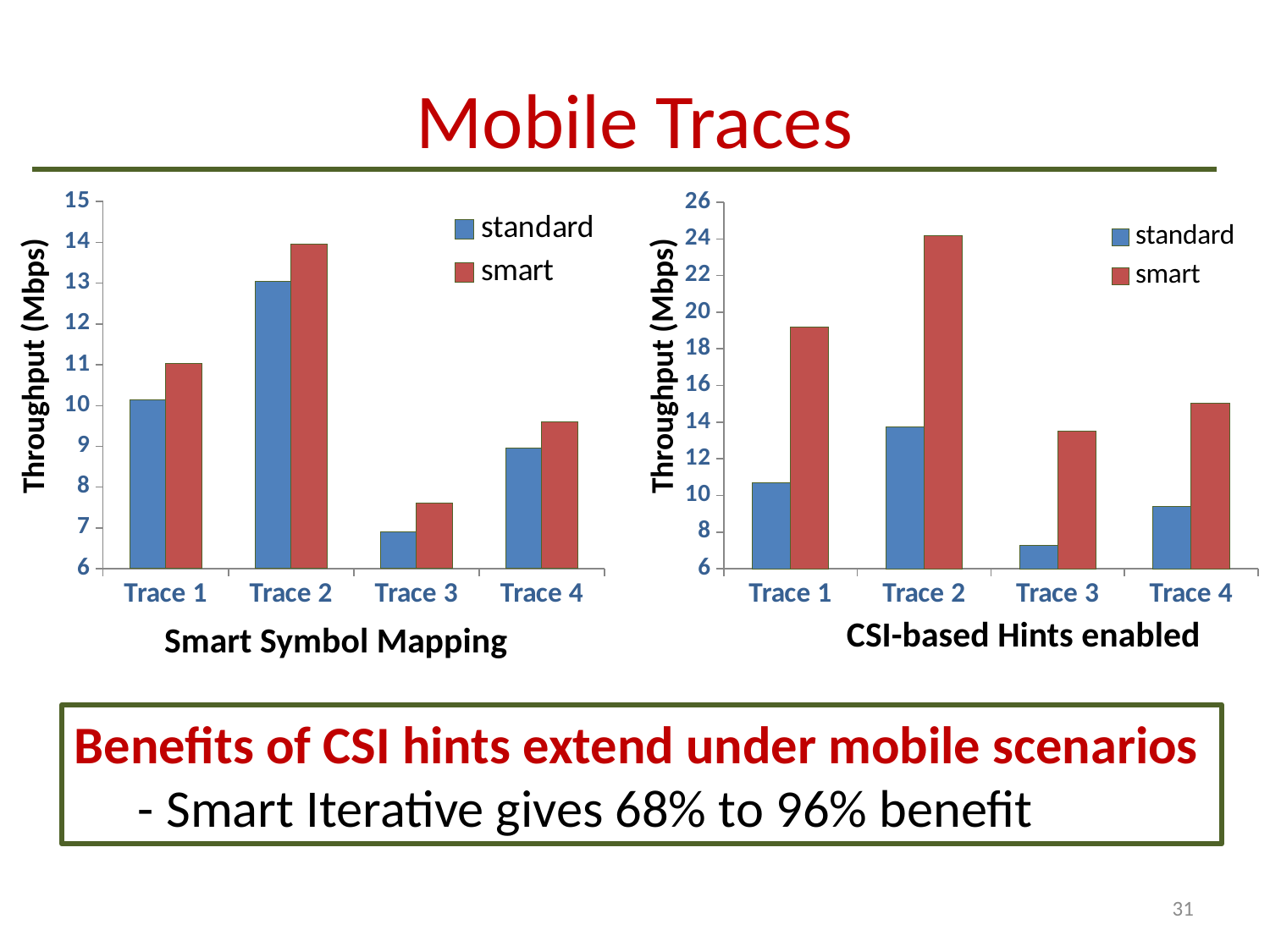
In the CSI-based Hints enabled chart, which is larger for Trace 4: the standard or the smart throughput? smart What is the y-axis label of the CSI-based Hints enabled chart? Throughput (Mbps) In the Smart Symbol Mapping chart, which trace has the lowest standard throughput? Trace 3 What kind of chart is the Smart Symbol Mapping chart on the left? bar chart In the CSI-based Hints enabled chart, is the smart value for Trace 1 greater or less than 18? greater How many series does the legend of the CSI-based Hints enabled chart list? 2 In the CSI-based Hints enabled chart, which trace has the lowest standard throughput? Trace 3 In the Smart Symbol Mapping chart, is the standard value for Trace 1 greater or less than 11? less In the Smart Symbol Mapping chart, which trace has the highest smart throughput? Trace 2 In the CSI-based Hints enabled chart, which trace has the highest smart throughput? Trace 2 How many traces are shown on the x axis of the Smart Symbol Mapping chart? 4